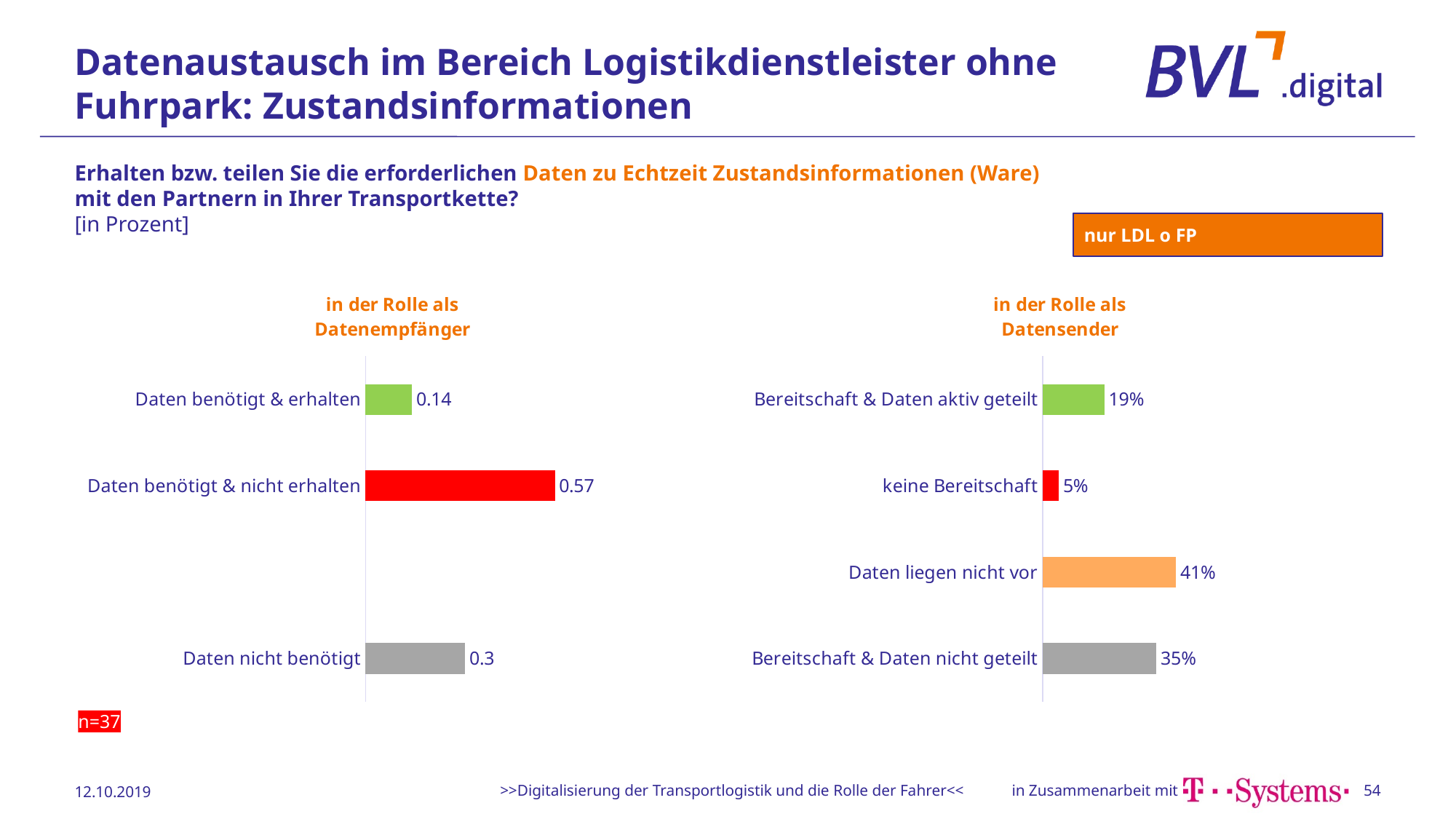
In the chart 'in der Rolle als Datenempfänger', what is the value for 'Daten benötigt & nicht erhalten'? 0.57 What kind of chart is the chart 'in der Rolle als Datenempfänger'? Bar chart In the chart 'in der Rolle als Datensender', what is the value for 'Daten liegen nicht vor'? 41% In the chart 'in der Rolle als Datensender', which is larger: 'Bereitschaft & Daten aktiv geteilt' or 'Bereitschaft & Daten nicht geteilt'? Bereitschaft & Daten nicht geteilt In the chart 'in der Rolle als Datenempfänger', which category has the highest value? Daten benötigt & nicht erhalten In the chart 'in der Rolle als Datensender', what is the difference between 'Daten liegen nicht vor' and 'Bereitschaft & Daten nicht geteilt'? 6% How many categories are shown in the chart 'in der Rolle als Datensender'? 4 In the chart 'in der Rolle als Datenempfänger', which category has the lowest value? Daten benötigt & erhalten In the chart 'in der Rolle als Datensender', which category has the highest value? Daten liegen nicht vor In the chart 'in der Rolle als Datenempfänger', what is the difference between 'Daten benötigt & nicht erhalten' and 'Daten benötigt & erhalten'? 0.43 In the chart 'in der Rolle als Datensender', what is the value for 'keine Bereitschaft'? 5% In the chart 'in der Rolle als Datenempfänger', what is the value for 'Daten nicht benötigt'? 0.3